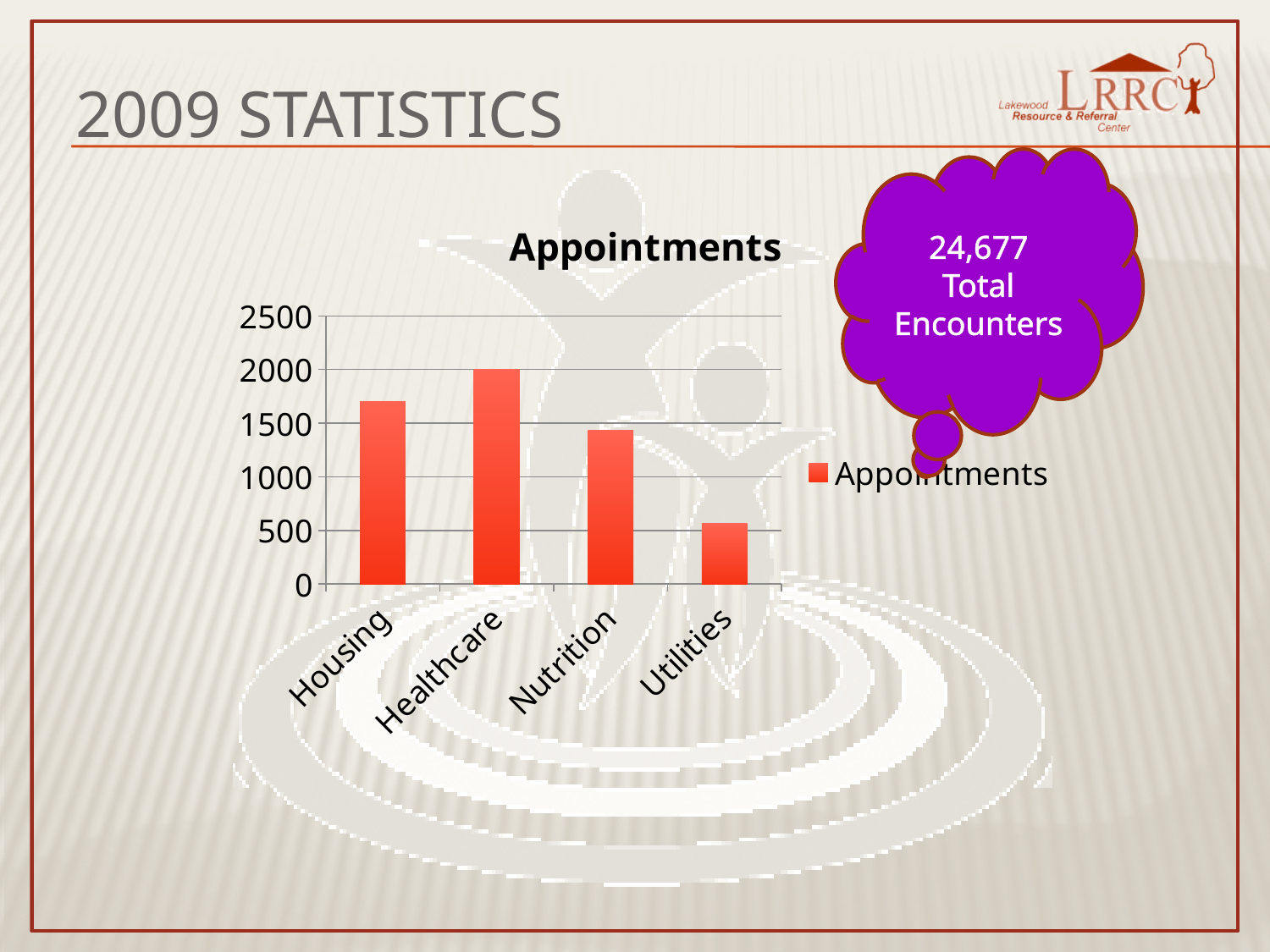
Is the value for Housing greater or less than 1500? greater Is the value for Utilities greater or less than 1000? less How many series does the chart's legend list? 1 Which category has the highest number of appointments? Healthcare What is the title of the chart? Appointments Which has more appointments, Housing or Nutrition? Housing How many categories are shown on the x axis of the chart? 4 Which has more appointments, Nutrition or Utilities? Nutrition Is the value for Nutrition greater or less than 1000? greater Which category has the lowest number of appointments? Utilities What kind of chart is shown on the slide? bar chart Do the bars rise or fall from Healthcare to Utilities along the x axis? fall